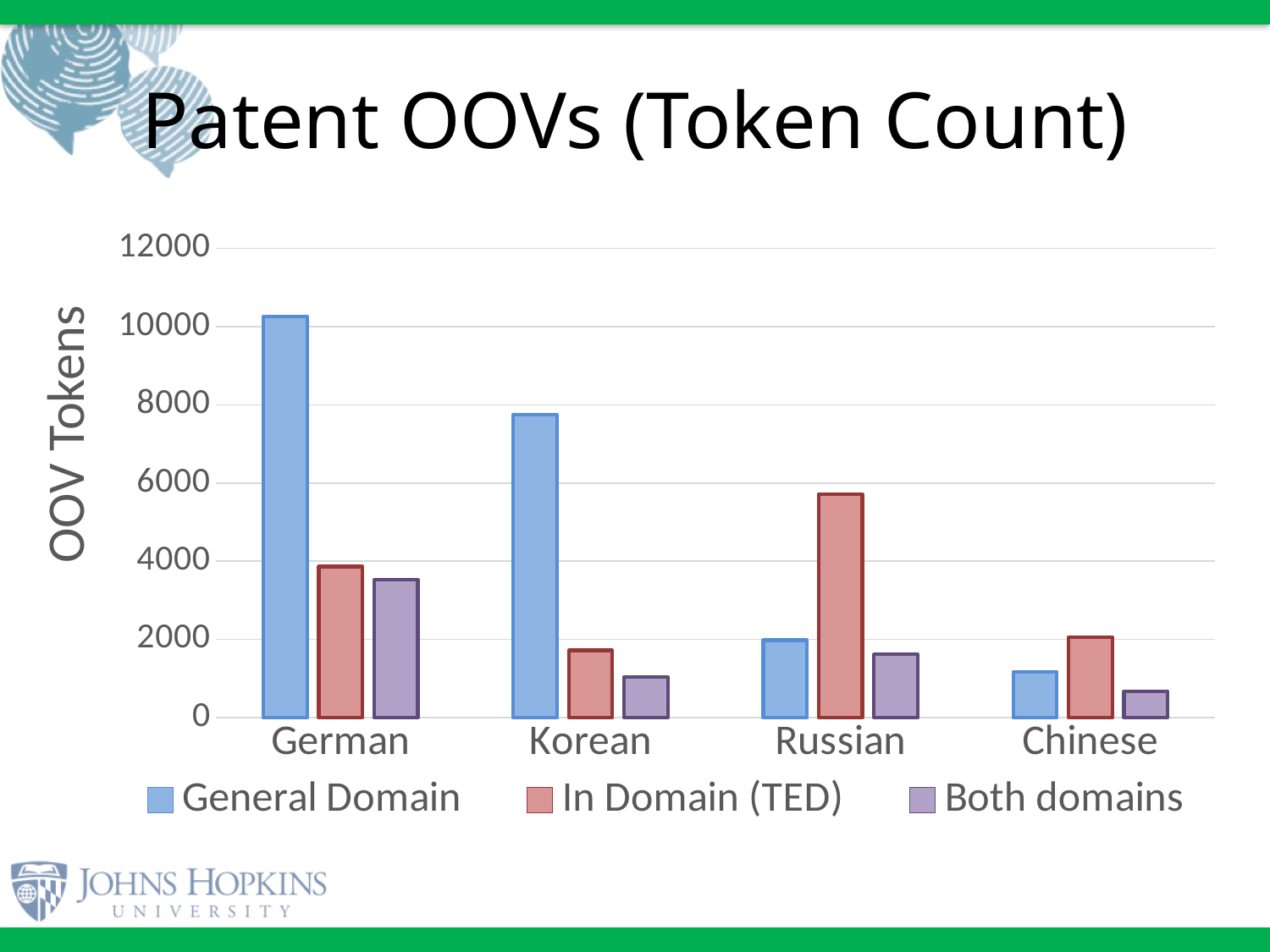
How many languages are shown on the x axis? 4 Is the In Domain (TED) value for Russian greater or less than 6000? less Is the General Domain value for Korean greater or less than 8000? less For Russian, which is larger: the General Domain bar or the In Domain (TED) bar? In Domain (TED) Which language has the lowest Both domains OOV token count? Chinese What kind of chart is shown on the slide? bar chart What is the label on the y axis of the chart? OOV Tokens Is the General Domain value for German greater or less than 10000? greater How many series does the legend list? 3 Which language has the highest In Domain (TED) OOV token count? Russian Which language has the highest General Domain OOV token count? German